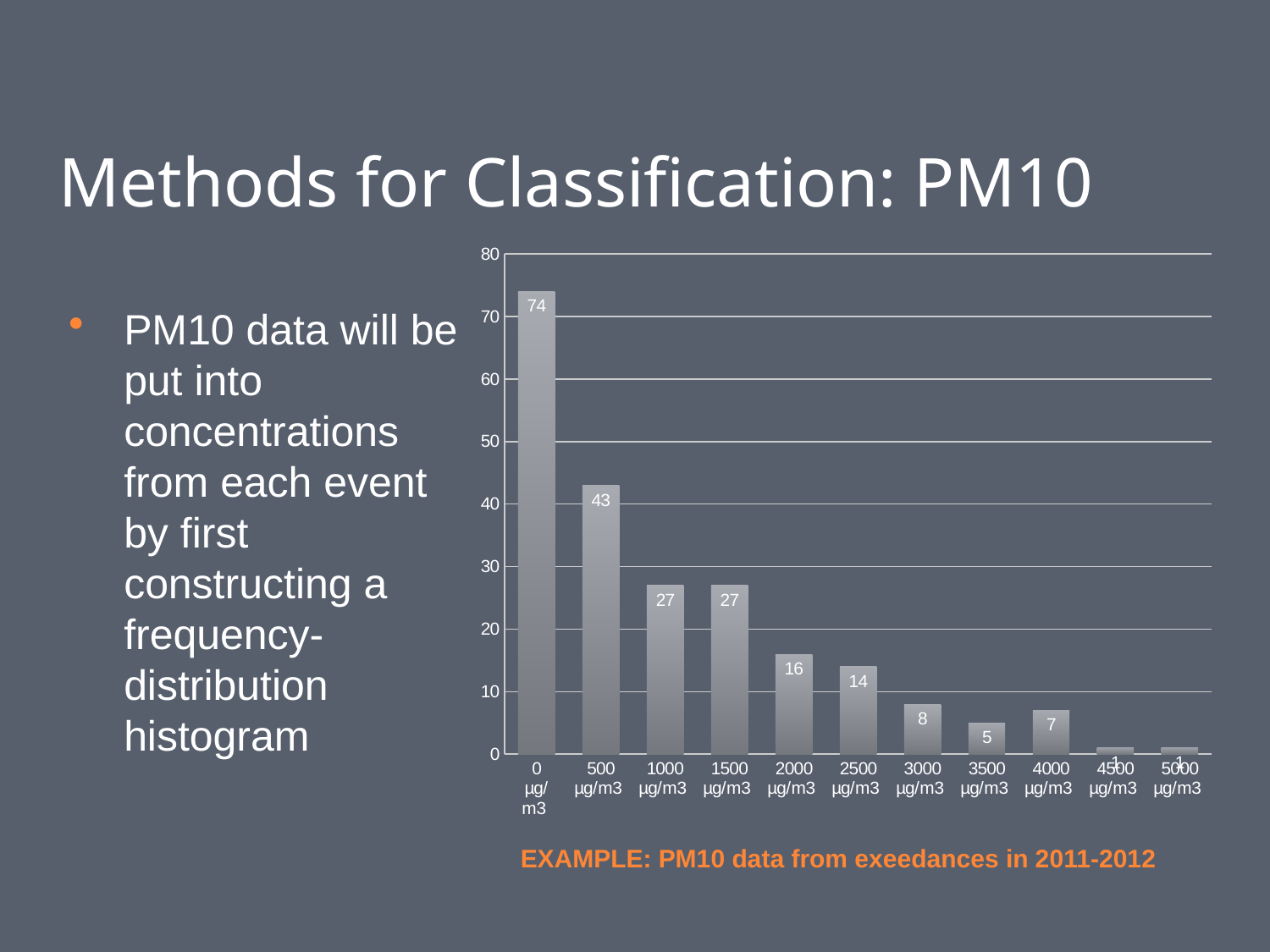
Is the value for 1000 µg/m3 greater or less than 30? less What is the difference between the values for 0 µg/m3 and 500 µg/m3? 31 What is the value for the 4000 µg/m3 category? 7 What is the value for the 2000 µg/m3 category? 16 What is the value for the 500 µg/m3 category? 43 What is the difference between the values for 2000 µg/m3 and 2500 µg/m3? 2 Which is larger, the value for 3500 µg/m3 or the value for 4000 µg/m3? 4000 µg/m3 What kind of chart is shown on the slide? bar chart What is the caption printed below the chart? EXAMPLE: PM10 data from exeedances in 2011-2012 How many categories are shown on the x axis? 11 Which category has the highest value? 0 µg/m3 What is the value for the 0 µg/m3 category? 74